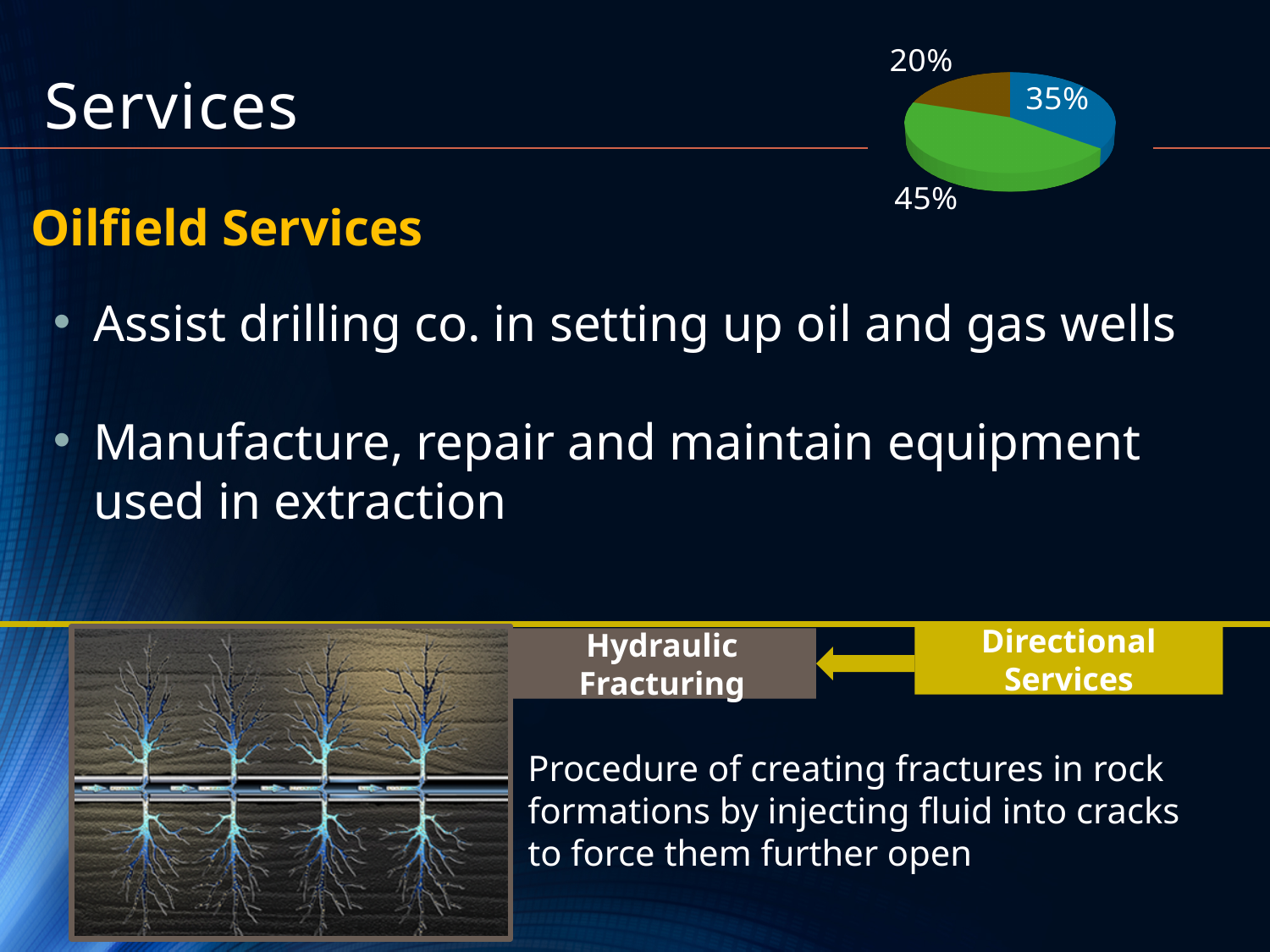
What is the difference in percentage points between the blue slice and the brown slice of the pie chart? 15 Which is larger in the pie chart, the blue slice or the brown slice? blue What percentage is shown for the blue slice of the pie chart? 35% What is the difference in percentage points between the green slice and the blue slice of the pie chart? 10 Which colour slice of the pie chart is the smallest? brown What is the combined share of the blue and brown slices of the pie chart? 55% What percentage is shown for the green slice of the pie chart? 45% How many slices does the pie chart have? 3 Does the pie chart have a legend? No What kind of chart is shown in the top right of the slide? pie chart Which colour slice of the pie chart is the largest? green What percentage is shown for the brown slice of the pie chart? 20%